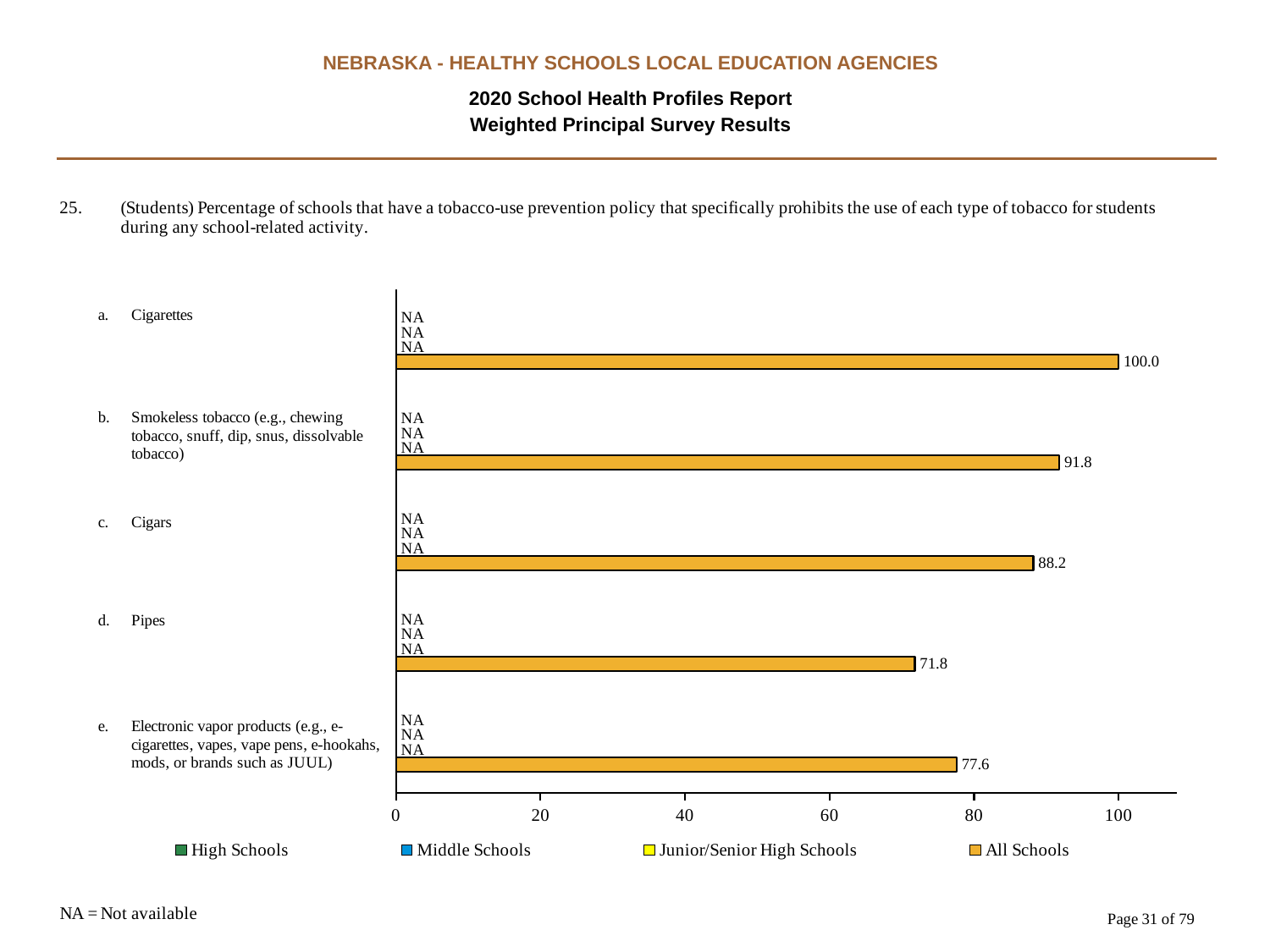
How many series does the legend list? 4 What is the All Schools value for Cigars? 88.2 What kind of chart is shown? Bar chart What is the All Schools value for Cigarettes? 100.0 Which is larger for All Schools: Cigars or Electronic vapor products? Cigars Which category has the highest All Schools value? Cigarettes How many categories are shown in the chart? 5 Which category has the lowest All Schools value? Pipes What is the All Schools value for Pipes? 71.8 What is the difference between the All Schools values for Cigarettes and Smokeless tobacco? 8.2 What value is shown for High Schools for Cigarettes? NA What is the All Schools value for Electronic vapor products? 77.6